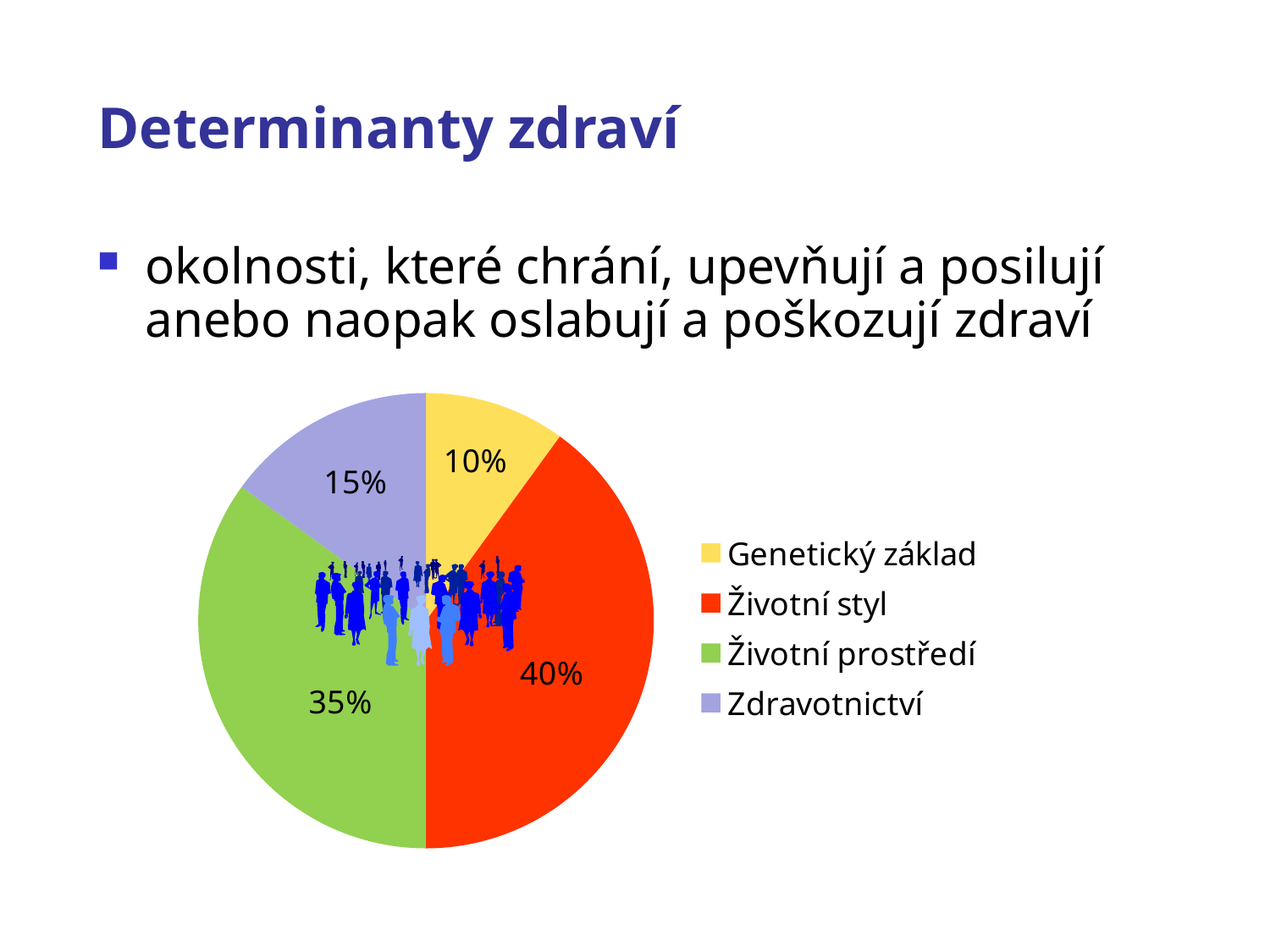
What share of the pie does Genetický základ have? 10% Which is larger, the slice for Zdravotnictví or the slice for Genetický základ? Zdravotnictví What share of the pie does Životní styl have? 40% What share of the pie does Životní prostředí have? 35% What is the difference in percentage points between Životní styl and Životní prostředí? 5% Which category has the largest slice of the pie? Životní styl What colour is the slice for Životní prostředí? green How many categories does the pie chart have? 4 Which category has the smallest slice of the pie? Genetický základ What is the difference in percentage points between Zdravotnictví and Genetický základ? 5% What share of the pie does Zdravotnictví have? 15% What kind of chart is shown on the slide? pie chart